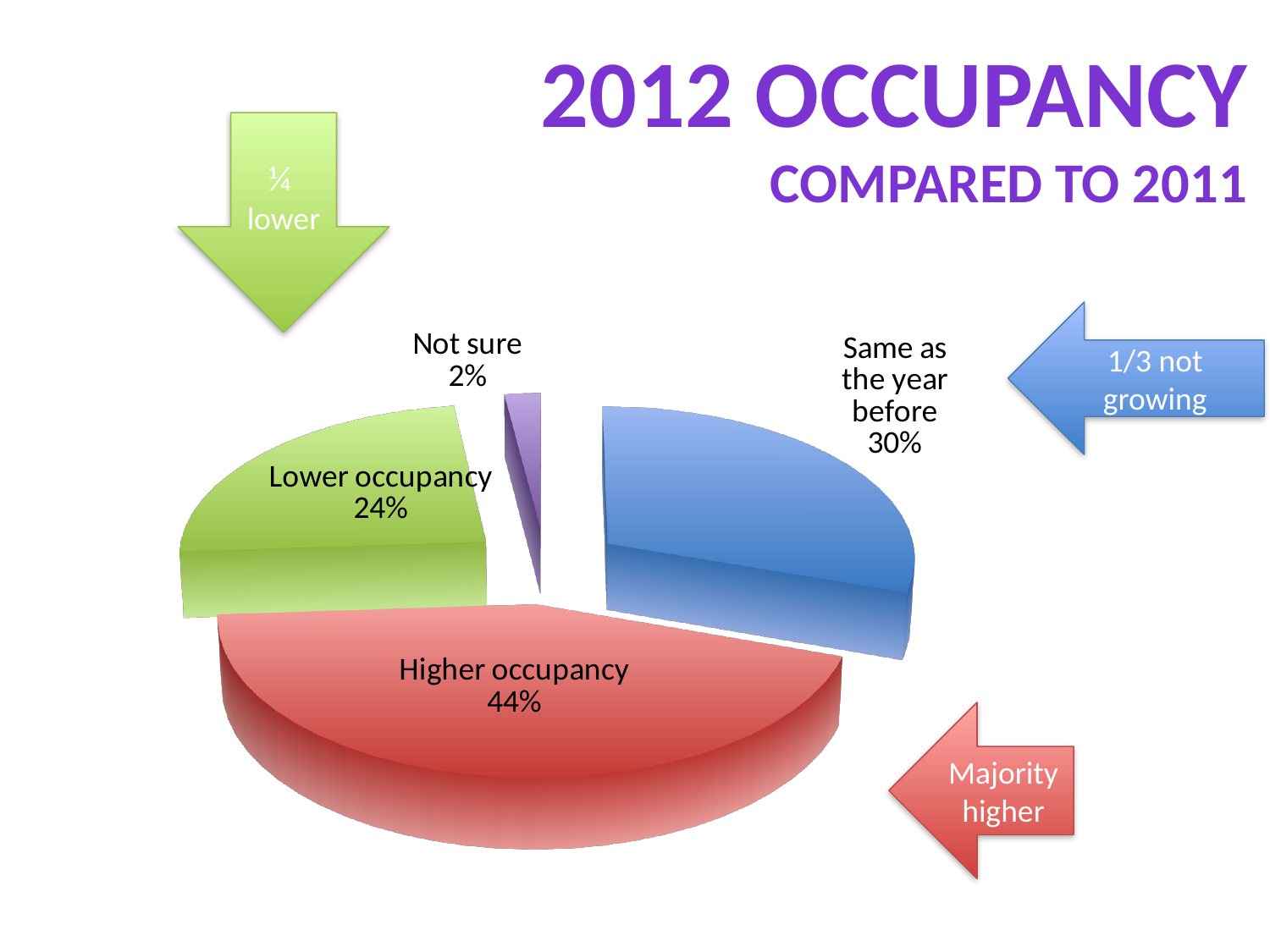
Which category has the largest share of the pie? Higher occupancy What percentage of respondents reported higher occupancy? 44% What is the title of the slide containing the pie chart? 2012 OCCUPANCY COMPARED TO 2011 What percentage of respondents were not sure? 2% What colour is the Higher occupancy slice? Red What percentage of respondents reported lower occupancy? 24% What percentage of respondents said occupancy was the same as the year before? 30% Which category has the smallest share of the pie? Not sure What kind of chart is shown on the slide? Pie chart What is the difference in percentage points between Higher occupancy and Lower occupancy? 20 Which is larger, the share for Same as the year before or the share for Lower occupancy? Same as the year before How many slices does the pie chart have? 4